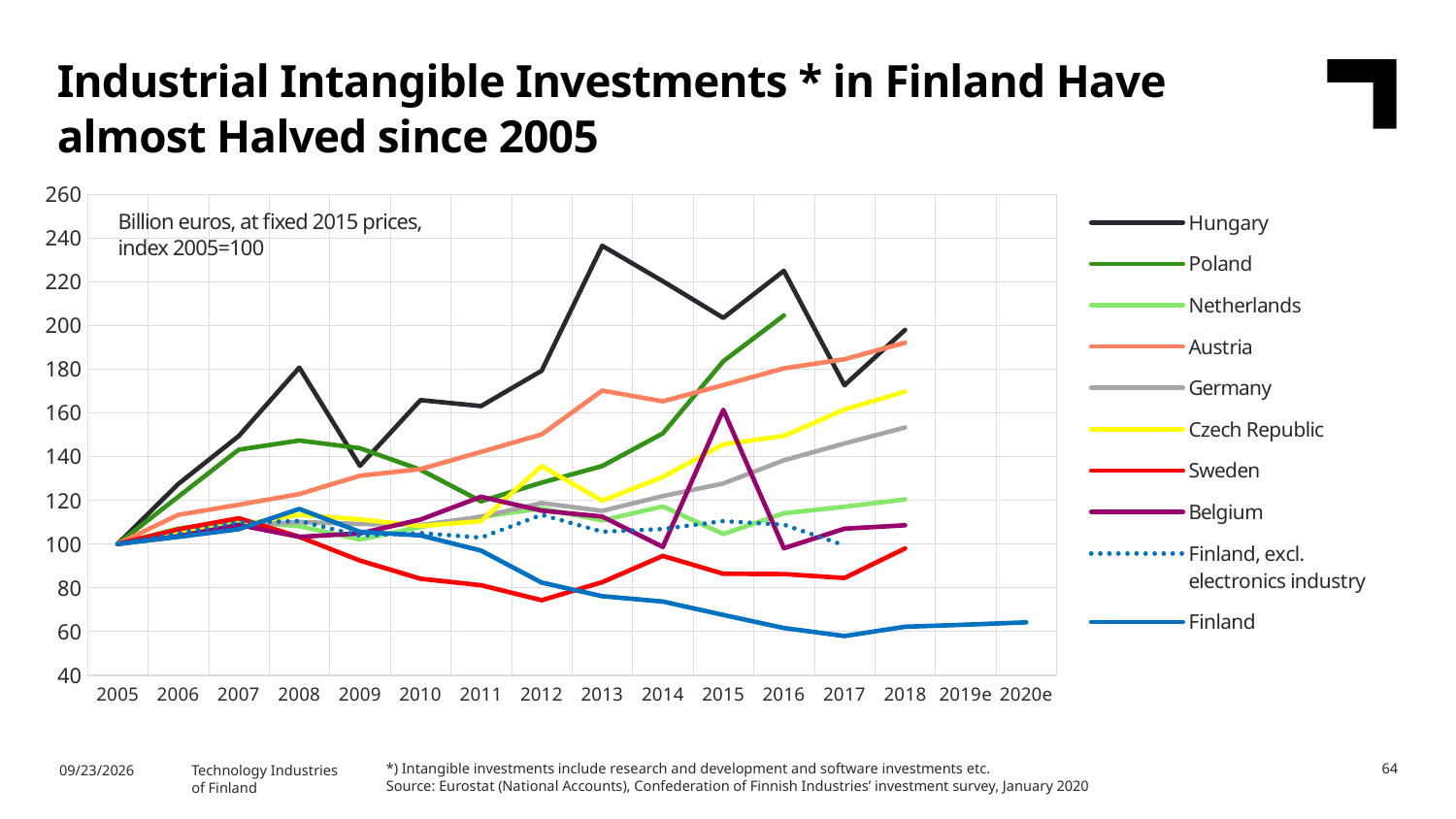
Does the value for Finland rise or fall from 2005 to 2020e? fall How many series does the legend list? 10 Which is larger in 2016, the value for Hungary or the value for Finland? Hungary Which series is drawn with a dotted line? Finland, excl. electronics industry Which country has the highest value in 2013? Hungary Is the value for Hungary in 2013 greater or less than 220? greater Which series has the lowest value in 2018? Finland What kind of chart is shown on the slide? line chart Is the value for Finland in 2020e greater or less than 80? less Is the value for Austria in 2018 greater or less than 180? greater How many years are shown on the x axis? 16 What is the index value for Finland in 2005? 100